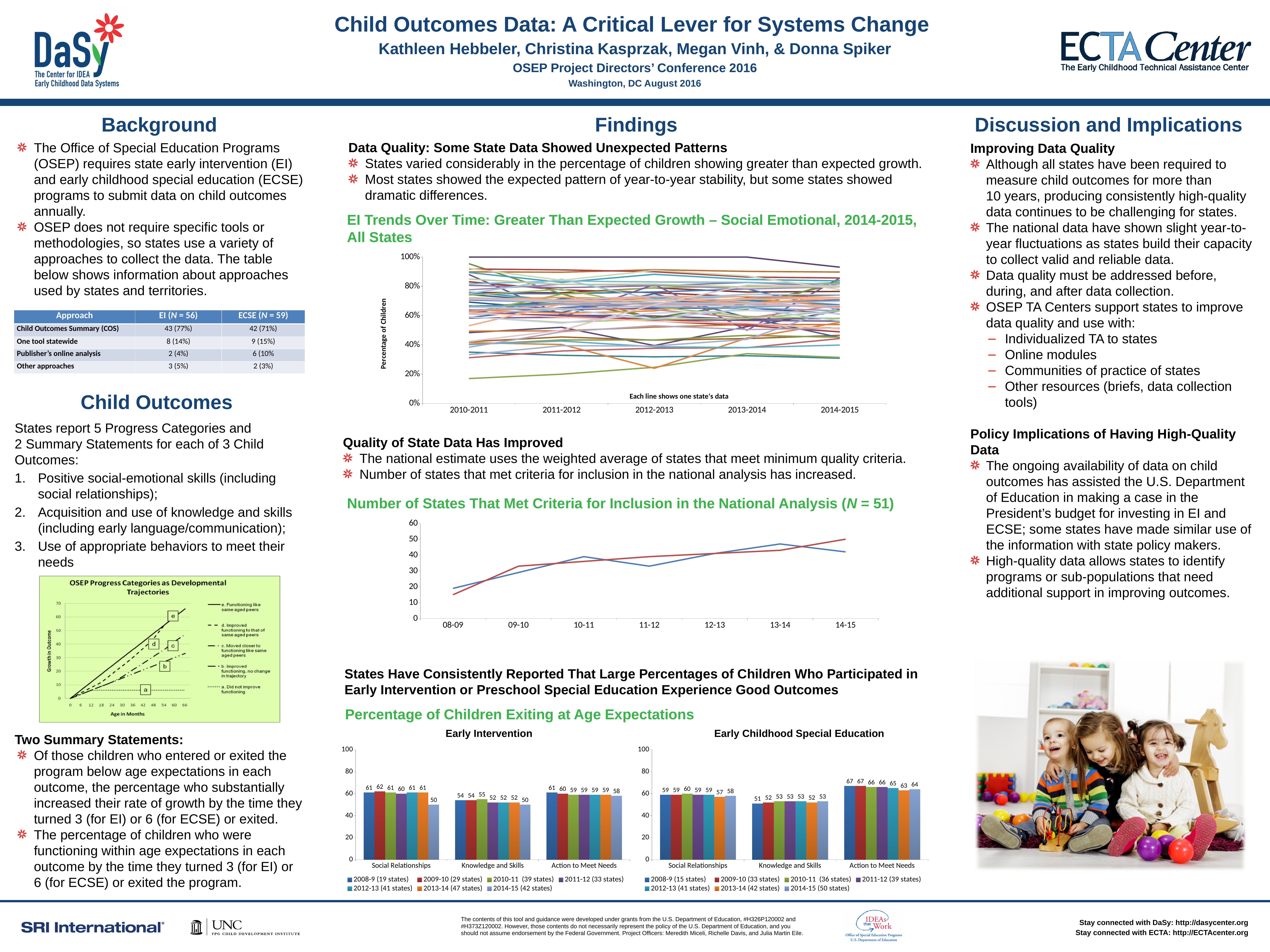
In the 'Number of States That Met Criteria for Inclusion in the National Analysis' chart, is the red line's value for 14-15 greater or less than 40? greater In the Early Childhood Special Education bar chart, which is larger for 2013-14 (42 states): Social Relationships or Knowledge and Skills? Social Relationships What kind of chart is 'Number of States That Met Criteria for Inclusion in the National Analysis (N = 51)'? line chart In the Early Intervention bar chart, what is the value for 2014-15 (42 states) in Social Relationships? 50 In the Early Childhood Special Education bar chart, which outcome category has the highest value for 2014-15 (50 states)? Action to Meet Needs How many series does the legend of the Early Intervention bar chart list? 7 In the Early Intervention bar chart, what is the difference between the 2008-9 (19 states) value and the 2014-15 (42 states) value in Social Relationships? 11 In the Early Intervention bar chart, what is the value for 2010-11 (39 states) in Knowledge and Skills? 55 In the Early Childhood Special Education bar chart, what is the value for 2008-9 (15 states) in Action to Meet Needs? 67 In the 'Number of States That Met Criteria for Inclusion in the National Analysis' chart, do the values generally rise or fall from 08-09 to 14-15? rise How many outcome categories are shown on the x axis of the Early Childhood Special Education bar chart? 3 How many school-year points are on the x axis of the 'EI Trends Over Time: Greater Than Expected Growth' line chart? 5